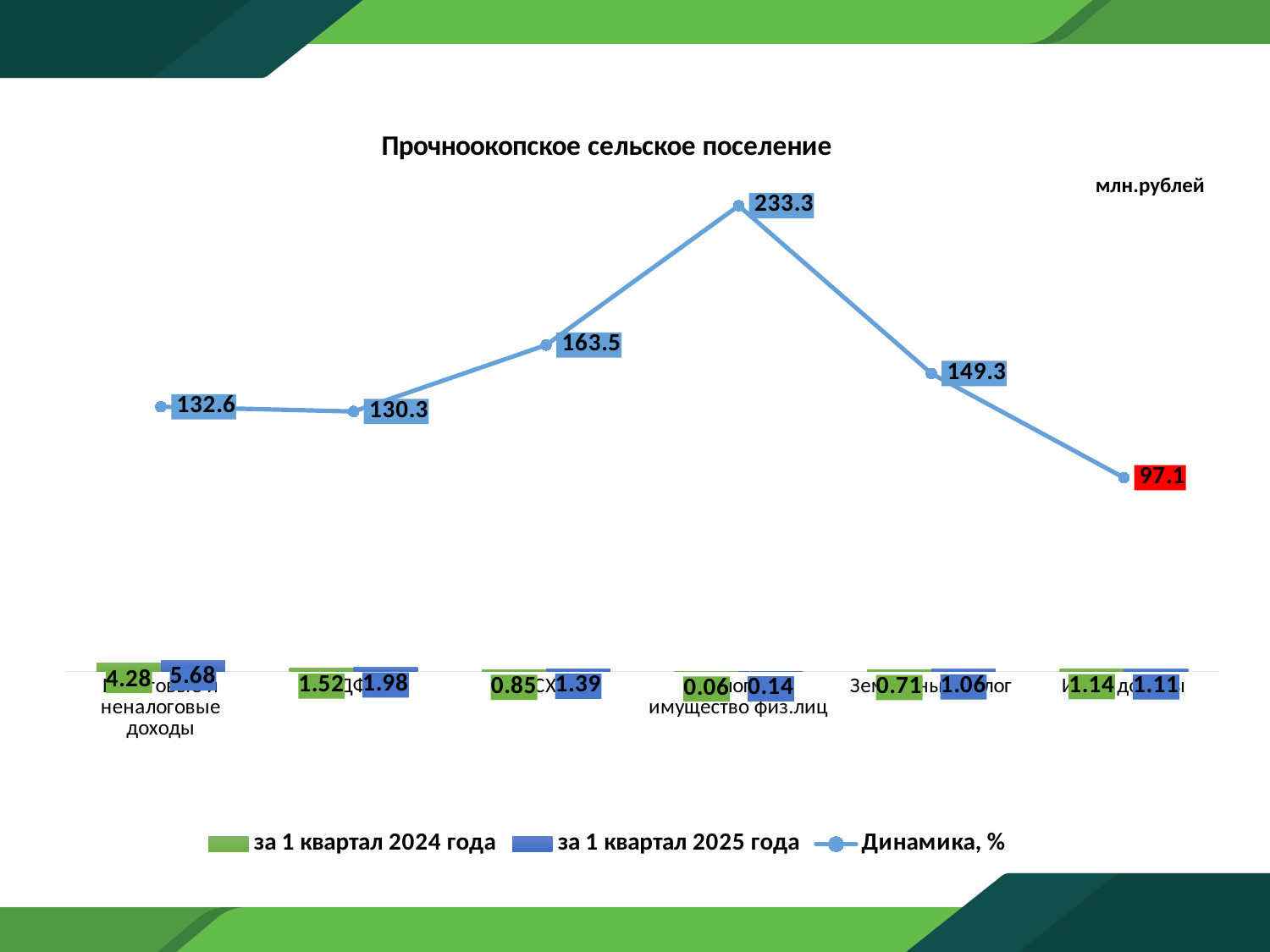
What is the title of the chart? Прочноокопское сельское поселение What is the value of 'за 1 квартал 2024 года' for the first category (Налоговые и неналоговые доходы)? 4.28 What kind of chart is shown on the slide? A combined bar and line chart What is the lowest value of the 'Динамика, %' line? 97.1 For the last (sixth) category, which is larger: the 2024 value (1.14) or the 2025 value (1.11)? за 1 квартал 2024 года What is the value of 'за 1 квартал 2025 года' for the first category (Налоговые и неналоговые доходы)? 5.68 What is the difference between the highest and lowest values of the 'Динамика, %' line? 136.2 How many categories are plotted along the x axis? 6 How many series does the legend list? 3 Does the 'Динамика, %' line rise or fall from the fourth category to the sixth category? Fall What is the highest value of the 'Динамика, %' line? 233.3 By how much does the 2025 value exceed the 2024 value for the first category (Налоговые и неналоговые доходы)? 1.40